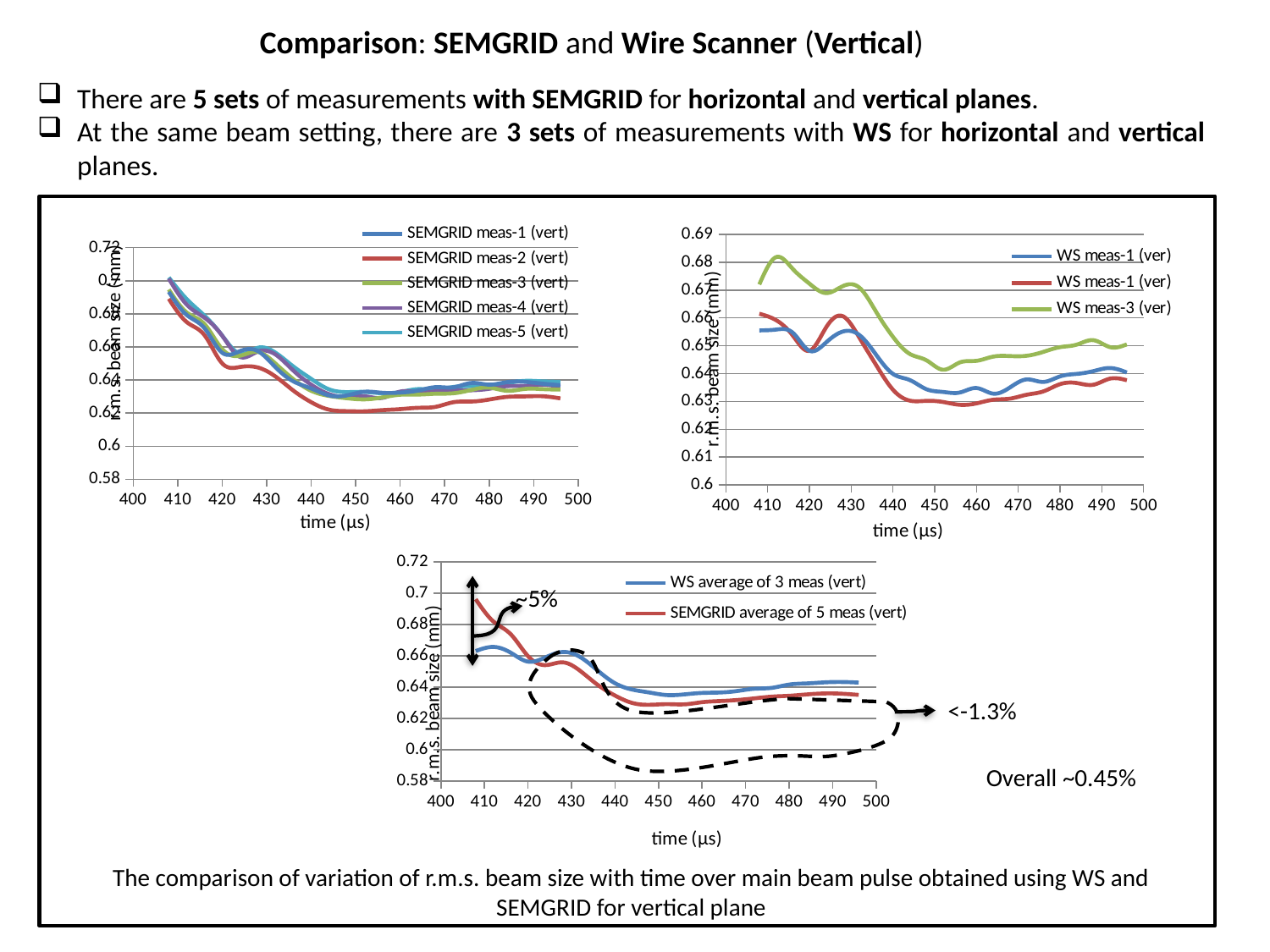
How many series does the legend of the top-left chart (SEMGRID meas) list? 5 How many series does the legend of the bottom chart (WS average vs SEMGRID average) list? 2 In the bottom chart, is the value of WS average of 3 meas (vert) at 450 µs greater or less than 0.64? less How many series does the legend of the top-right chart (WS meas) list? 3 In the bottom chart, which series is higher at 480 µs, WS average of 3 meas (vert) or SEMGRID average of 5 meas (vert)? WS average of 3 meas (vert) What type of chart is the top-left chart with the SEMGRID measurements? Line chart In the top-right chart, is the value of WS meas-3 (ver) at 450 µs greater or less than 0.65? less How many charts are shown on the slide? 3 In the top-right chart, which series has the highest r.m.s. beam size at 450 µs? WS meas-3 (ver) What is the y-axis label of the top-right chart? r.m.s. beam size (mm) What is the x-axis label of the bottom chart? time (µs) In the top-left chart, do the SEMGRID r.m.s. beam size values generally rise or fall as time increases from 410 to 450 µs? Fall